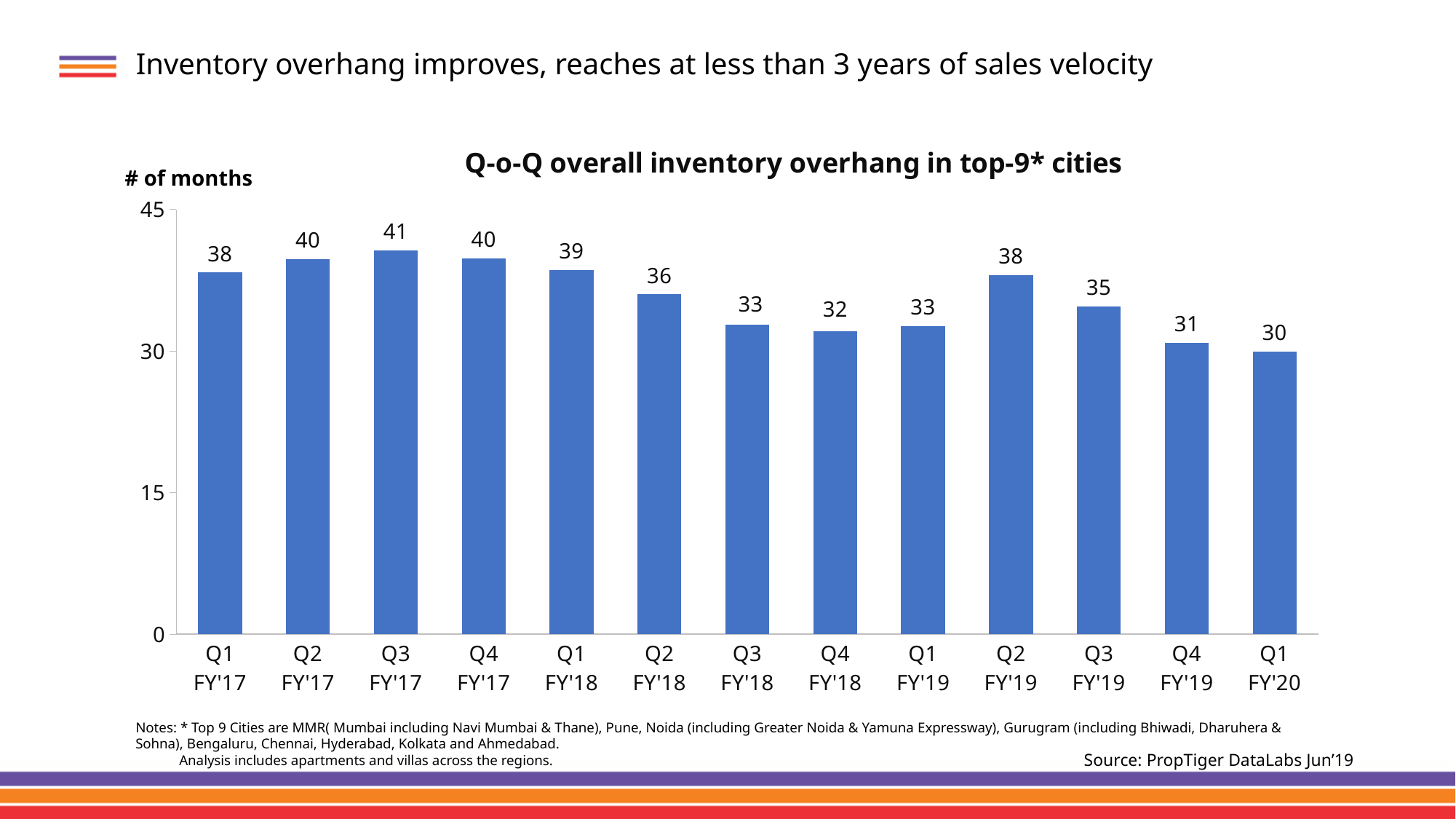
What is the difference in inventory overhang between Q2 FY'19 and Q3 FY'19? 3 What kind of chart is shown on the slide? Bar chart What is the inventory overhang (in months) for Q2 FY'19? 38 Which is larger, the inventory overhang for Q2 FY'18 or for Q4 FY'18? Q2 FY'18 What is the inventory overhang (in months) for Q1 FY'20? 30 What is the title of the chart? Q-o-Q overall inventory overhang in top-9* cities Which quarter has the highest inventory overhang? Q3 FY'17 Is the value for Q4 FY'19 greater or less than 30? greater What is the difference in inventory overhang between Q3 FY'17 and Q1 FY'20? 11 What is the inventory overhang (in months) for Q3 FY'17? 41 How many quarters are shown on the chart? 13 Which quarter has the lowest inventory overhang? Q1 FY'20